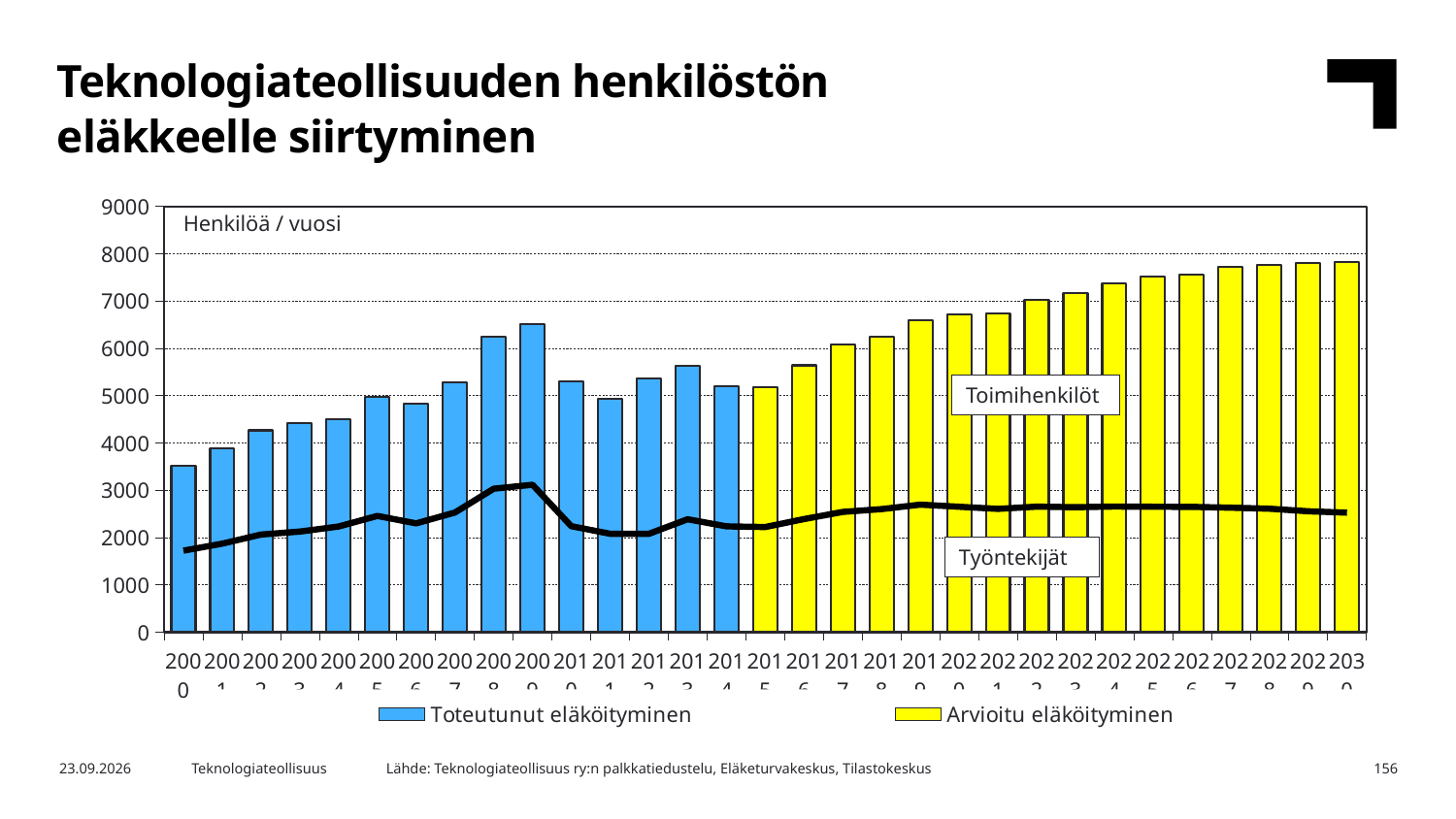
Is the bar for 2020 greater or less than 6000? greater Is the Työntekijät line value for 2000 greater or less than 2000? less Which year has the lowest bar? 2000 What kind of chart is shown on the slide? combination bar and line chart What unit label is shown inside the plot area at the top left? Henkilöä / vuosi How many series does the legend list? 2 What are the two legend entries? Toteutunut eläköityminen, Arvioitu eläköityminen Do the bars rise or fall from 2015 to 2030? rise Is the bar for 2030 greater or less than 8000? less Which bar is taller, 2008 or 2009? 2009